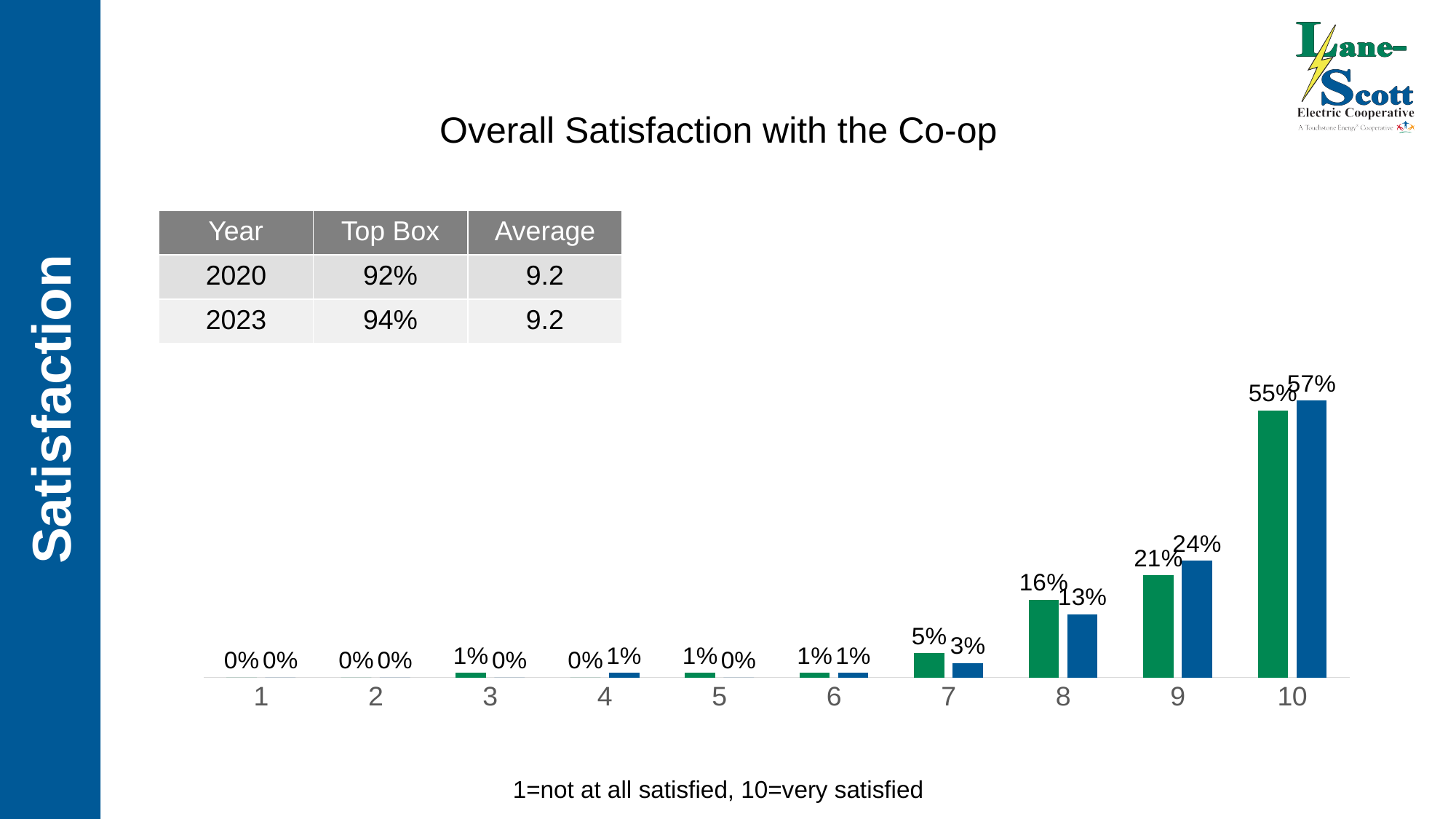
What is the difference between the green bar and the blue bar for category 8? 3% What is the value of the blue bar for category 9? 24% What is the value of the green bar for category 8? 16% Which category has the highest blue bar? 10 What is the difference between the blue bar and the green bar for category 10? 2% What is the value of the green bar for category 7? 5% How many categories are shown on the x axis of the chart? 10 For category 9, which bar is larger, the green or the blue? blue Do the bar values generally rise or fall from category 1 to category 10? rise What is the value of the blue bar for category 10? 57% What kind of chart is shown on the slide? bar chart What is the value of the green bar for category 10? 55%